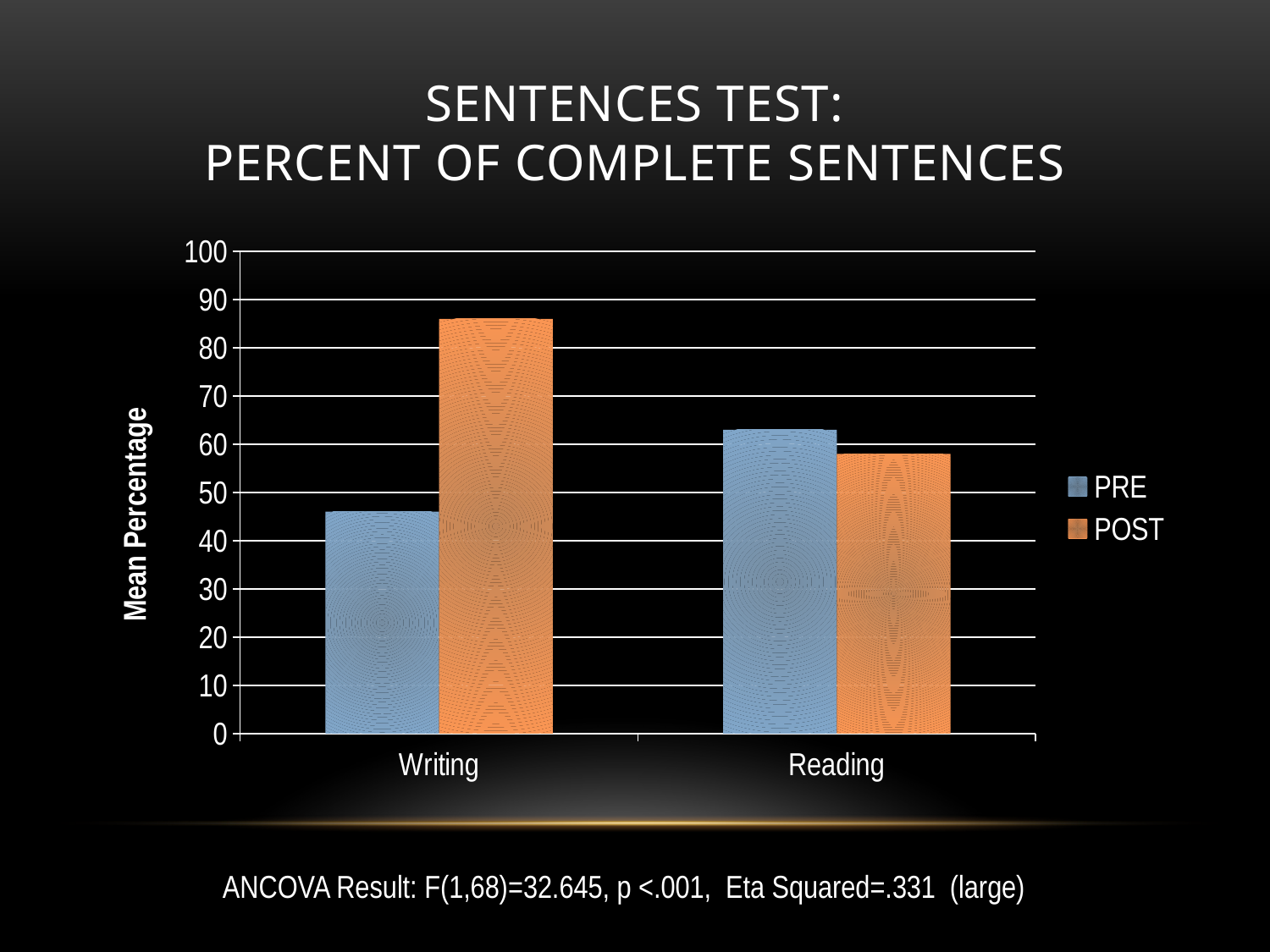
For Reading, which is larger, PRE or POST? PRE Is the POST value for Writing greater or less than 90? less How many categories are shown on the x axis? 2 For Writing, which is larger, PRE or POST? POST What kind of chart is shown on the slide? bar chart Is the POST value for Reading greater or less than 50? greater Is the POST value for Writing greater or less than 80? greater Which bar is the highest in the chart? Writing POST What is the label on the vertical axis? Mean Percentage Which bar is the lowest in the chart? Writing PRE How many series does the legend list? 2